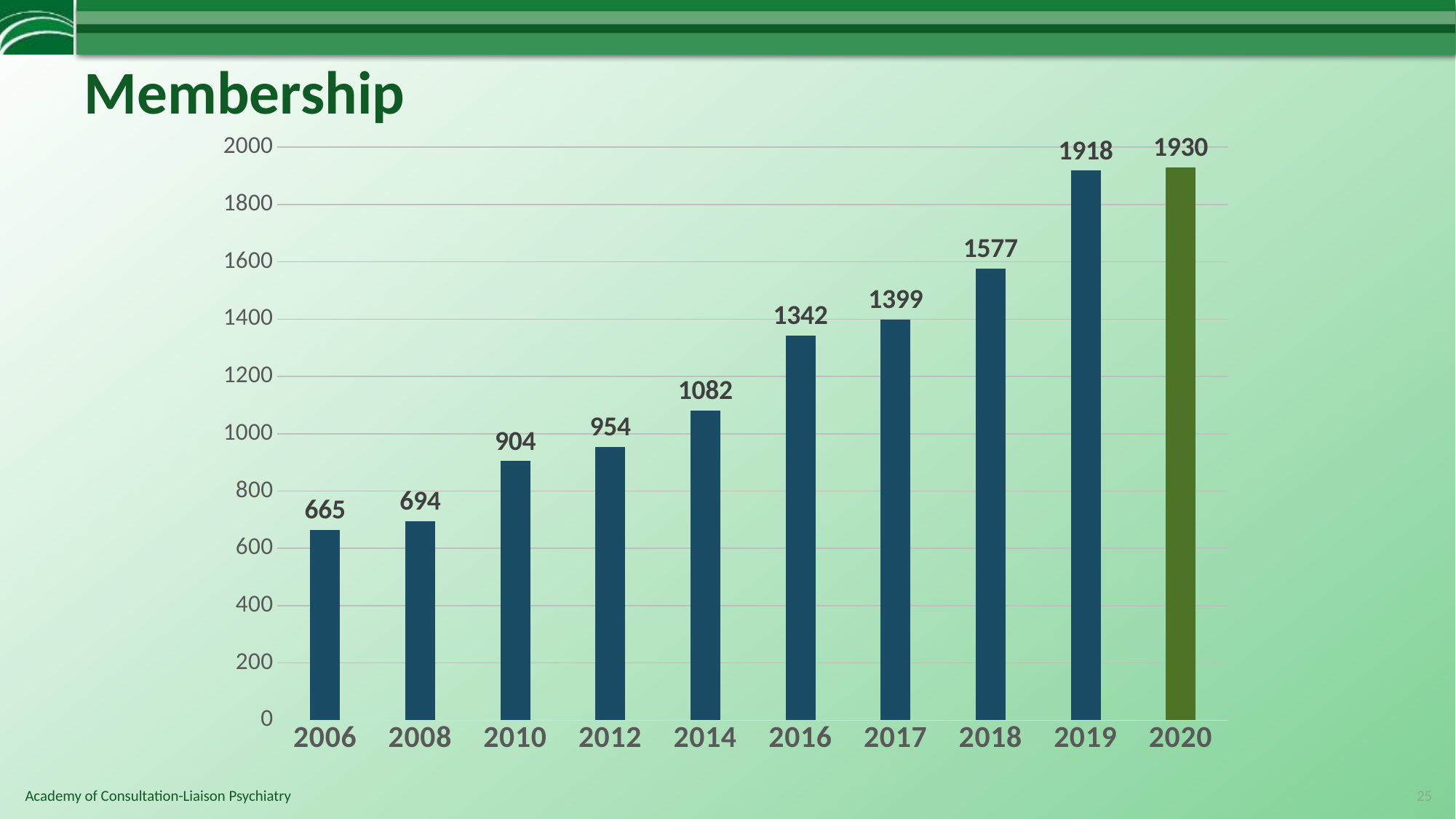
What is the difference in membership between 2016 and 2012? 388 What is the membership value for 2006? 665 What is the membership value for 2014? 1082 How many years are shown on the x axis? 10 Do membership values rise or fall from 2006 to 2020? rise Which year has a larger membership, 2010 or 2017? 2017 Which year has the lowest membership? 2006 What kind of chart is shown on the slide? bar chart Which year has the highest membership? 2020 What is the membership value for 2018? 1577 Is the membership value for 2012 greater or less than 1000? less What is the difference in membership between 2019 and 2018? 341